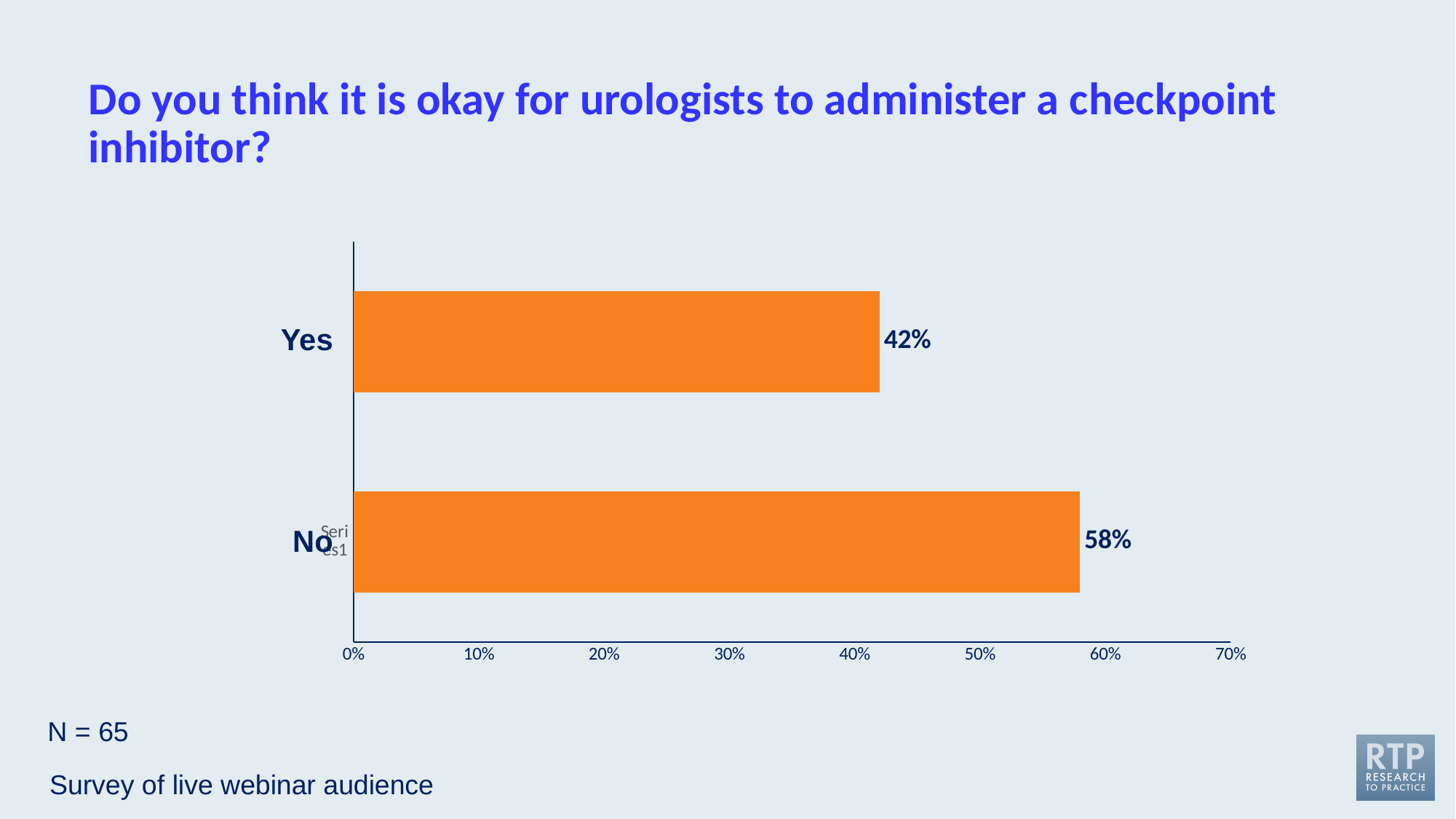
How many response categories are shown in the chart? 2 What is the difference in percentage points between the No and Yes responses? 16% Is the value for Yes greater or less than 50%? less What type of chart is shown on the slide? Bar chart What is the maximum value shown on the horizontal axis? 70% Is the value for No greater or less than 50%? greater Which response has the larger share, Yes or No? No What percentage of respondents answered Yes? 42% Which response received the lowest percentage? Yes What percentage of respondents answered No? 58% Which response received the highest percentage? No How many respondents (N) took part in the survey? 65